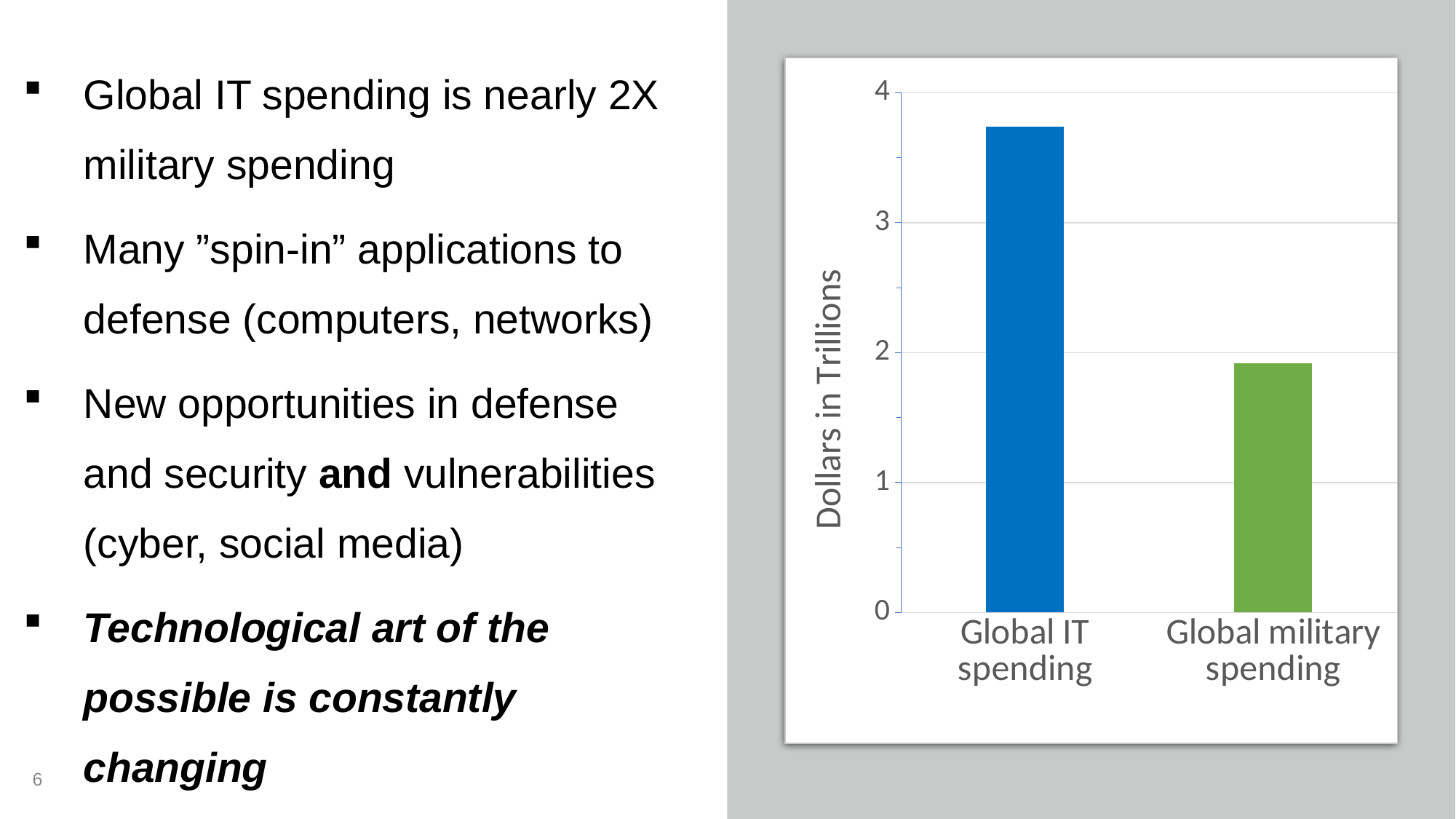
What colour is the bar for Global military spending? green Is the value for Global military spending greater or less than 2? less What kind of chart is shown on the slide? bar chart How many categories are plotted in the chart? 2 Is the value for Global military spending greater or less than 1? greater Which category has the highest value in the chart? Global IT spending Which is larger, Global IT spending or Global military spending? Global IT spending Which category has the lowest value in the chart? Global military spending Is the value for Global IT spending greater or less than 3? greater What is the label of the vertical axis of the chart? Dollars in Trillions